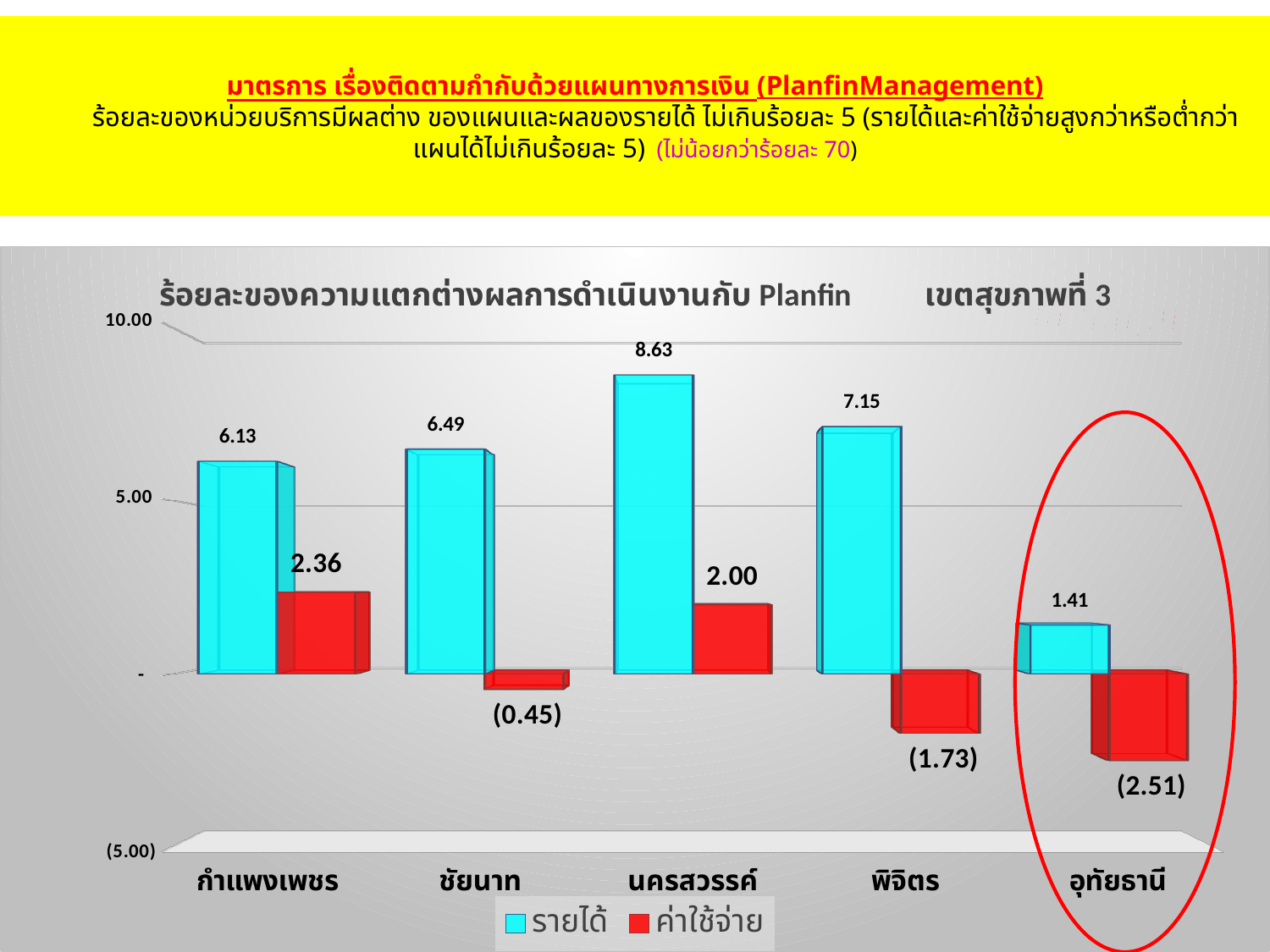
How many series does the legend list? 2 Is the รายได้ value for พิจิตร greater or less than 5.00? greater Which is larger, the ค่าใช้จ่าย value for กำแพงเพชร or for นครสวรรค์? กำแพงเพชร Which province has the lowest รายได้ value? อุทัยธานี How many provinces are shown on the x axis? 5 What is the ค่าใช้จ่าย value for อุทัยธานี? (2.51) Which province has the highest รายได้ value? นครสวรรค์ What is the ค่าใช้จ่าย value for ชัยนาท? (0.45) What kind of chart is shown on the slide? bar chart What is the รายได้ value for นครสวรรค์? 8.63 What is the difference between the รายได้ values for นครสวรรค์ and พิจิตร? 1.48 Which province has the lowest ค่าใช้จ่าย value? อุทัยธานี